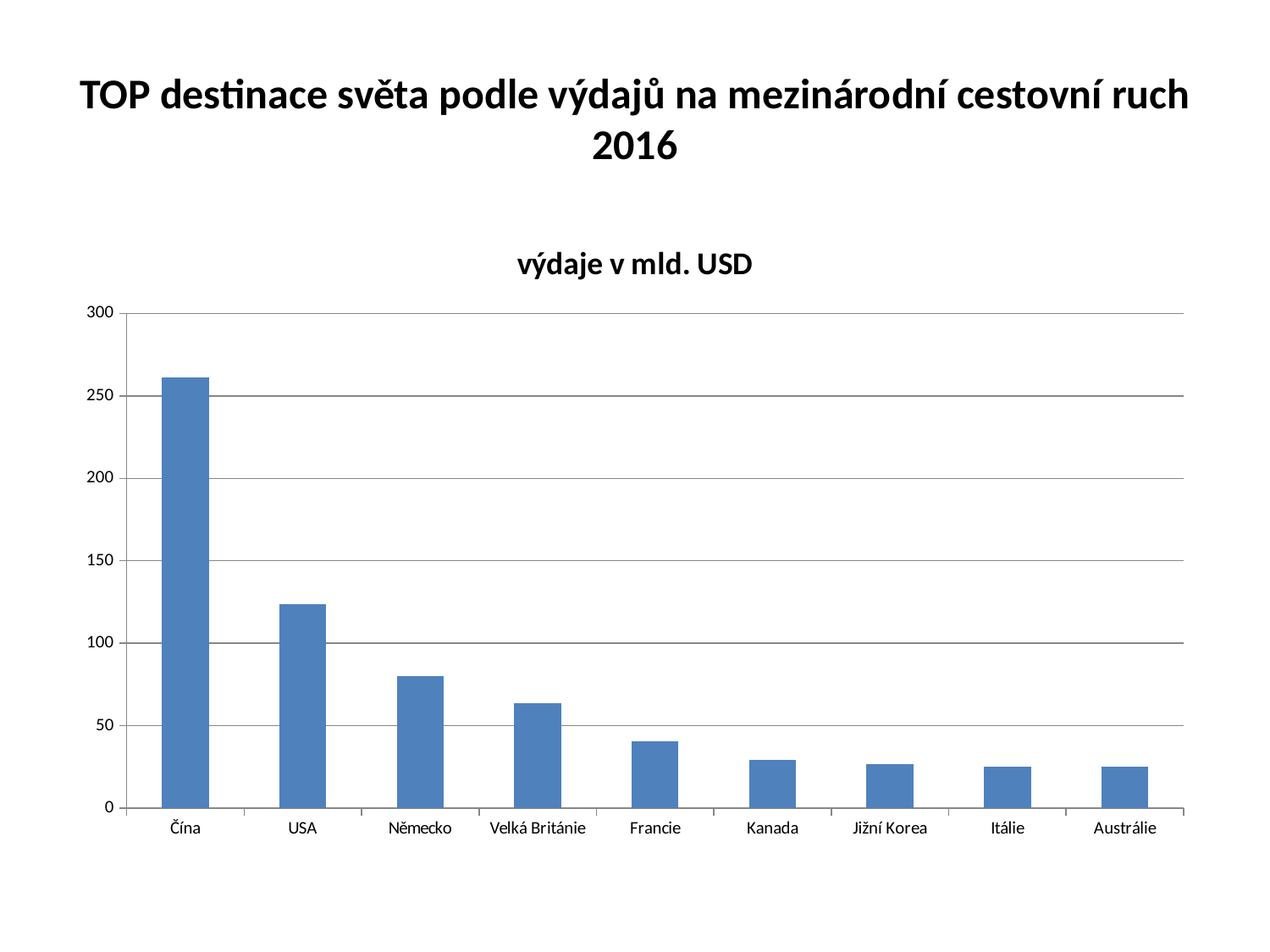
Do the values rise or fall moving from left to right along the x axis? fall Is the value for Německo greater or less than 100? less How many countries are shown on the x axis of the chart? 9 What kind of chart is shown on the slide? bar chart Which country has the highest value in the chart? Čína What is the title shown above the chart? výdaje v mld. USD Which is larger, the value for USA or the value for Německo? USA Is the value for Kanada greater or less than 50? less Is the value for Čína greater or less than 250? greater